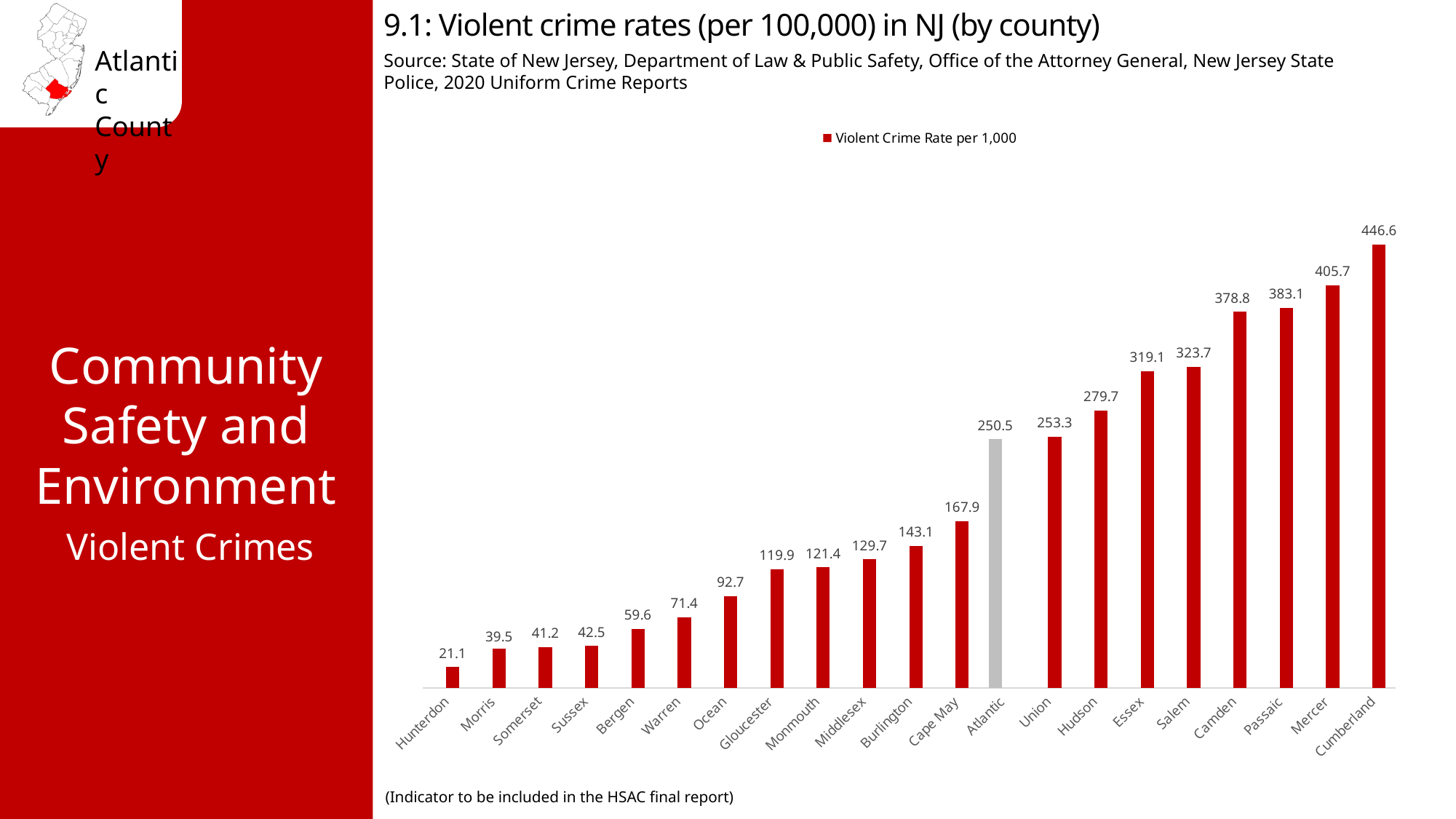
What is the difference between the violent crime rates of Essex and Union? 65.8 What is the violent crime rate shown for Hudson? 279.7 What is the violent crime rate shown for Atlantic county? 250.5 What type of chart is shown on the slide? Bar chart Which county has a higher violent crime rate, Camden or Salem? Camden How many series does the legend list? 1 What is the violent crime rate shown for Cape May? 167.9 Which county has the lowest violent crime rate on the chart? Hunterdon Which county has the highest violent crime rate on the chart? Cumberland What is the difference between the violent crime rates of Cumberland and Hunterdon? 425.5 How many counties are shown on the chart? 21 Which county's bar is shown in grey rather than red? Atlantic